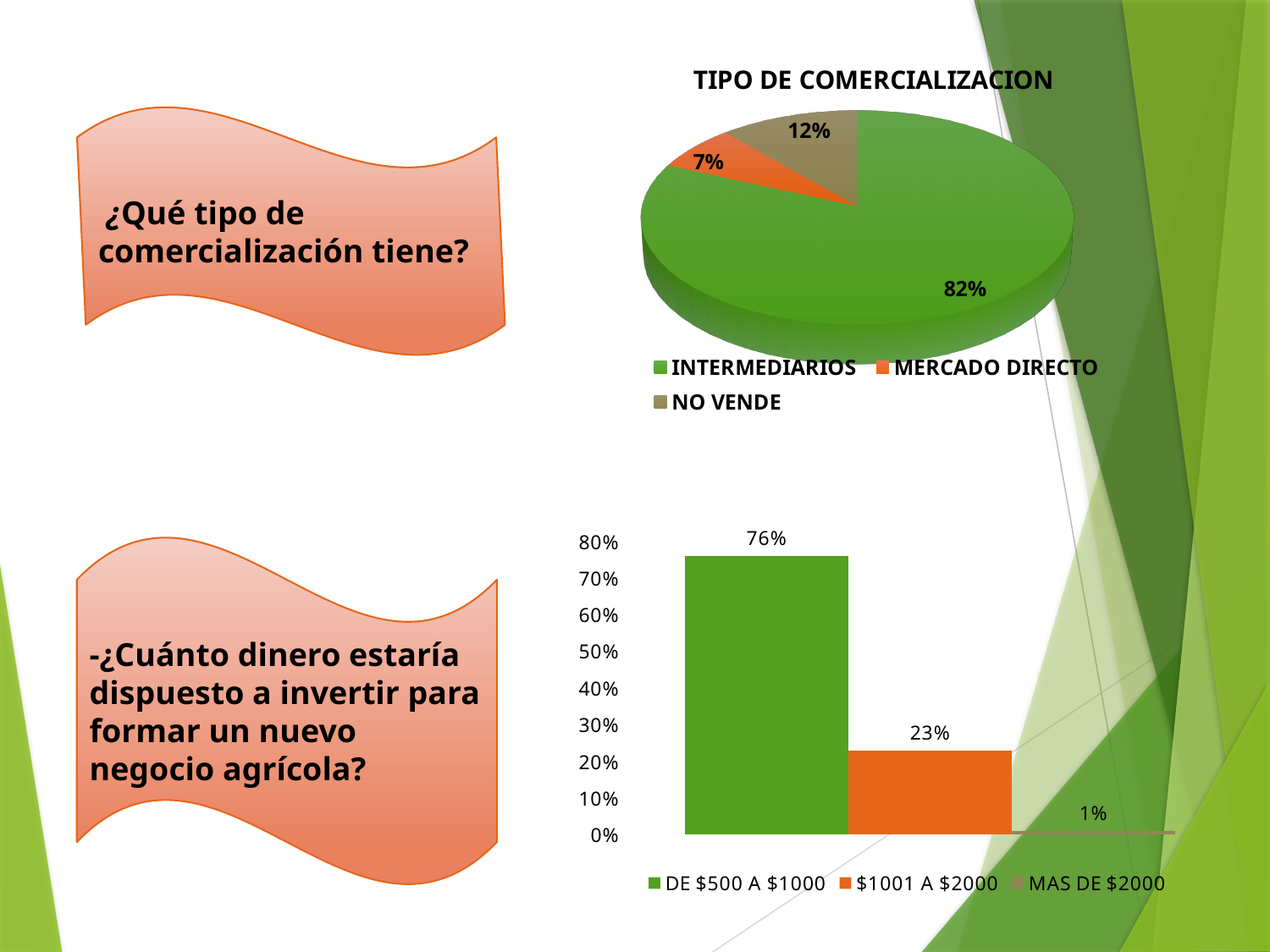
In the bar chart at the bottom of the slide, what value is shown for DE $500 A $1000? 76% What kind of chart is the chart titled TIPO DE COMERCIALIZACION? Pie chart How many categories does the legend of the chart titled TIPO DE COMERCIALIZACION list? 3 In the chart titled TIPO DE COMERCIALIZACION, what is the difference in percentage points between INTERMEDIARIOS and NO VENDE? 70 In the chart titled TIPO DE COMERCIALIZACION, what percentage is shown for MERCADO DIRECTO? 7% In the bar chart at the bottom of the slide, what value is shown for $1001 A $2000? 23% In the chart titled TIPO DE COMERCIALIZACION, what percentage is shown for INTERMEDIARIOS? 82% In the bar chart at the bottom of the slide, what is the difference in percentage points between DE $500 A $1000 and $1001 A $2000? 53 In the chart titled TIPO DE COMERCIALIZACION, which category has the smallest share? MERCADO DIRECTO In the bar chart at the bottom of the slide, which category has the lowest value? MAS DE $2000 In the chart titled TIPO DE COMERCIALIZACION, what percentage is shown for NO VENDE? 12% In the chart titled TIPO DE COMERCIALIZACION, which category has the largest share? INTERMEDIARIOS